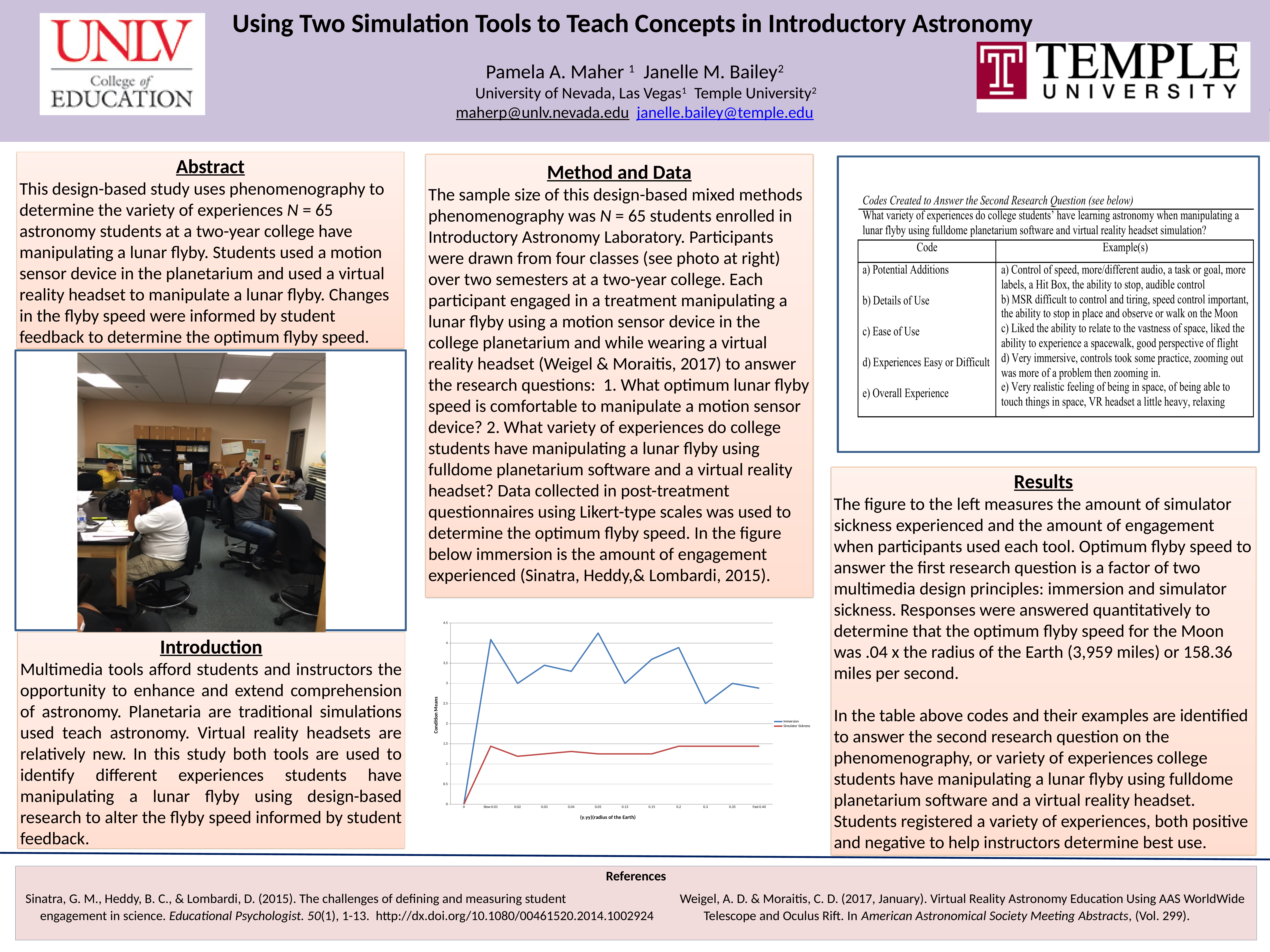
On the line chart, is the Simulator Sickness value at 0.02 greater or less than 1.5? less On the line chart, at which x-axis category is the Immersion series lowest? 0 On the line chart, is the Immersion value at 0.05 greater or less than 4? greater How many series does the legend of the line chart list? 2 What is the label on the y axis of the line chart? Condition Means On the line chart, which series has the larger value at 0.2, Immersion or Simulator Sickness? Immersion How many x-axis categories (flyby speeds) are plotted on the line chart? 12 On the line chart, does the Immersion series rise or fall between 0.2 and 0.3? fall On the line chart, is the Immersion value at 0.02 greater or less than 3.5? less What kind of chart is shown at the bottom centre of the poster? line chart Which series on the line chart is drawn in red? Simulator Sickness